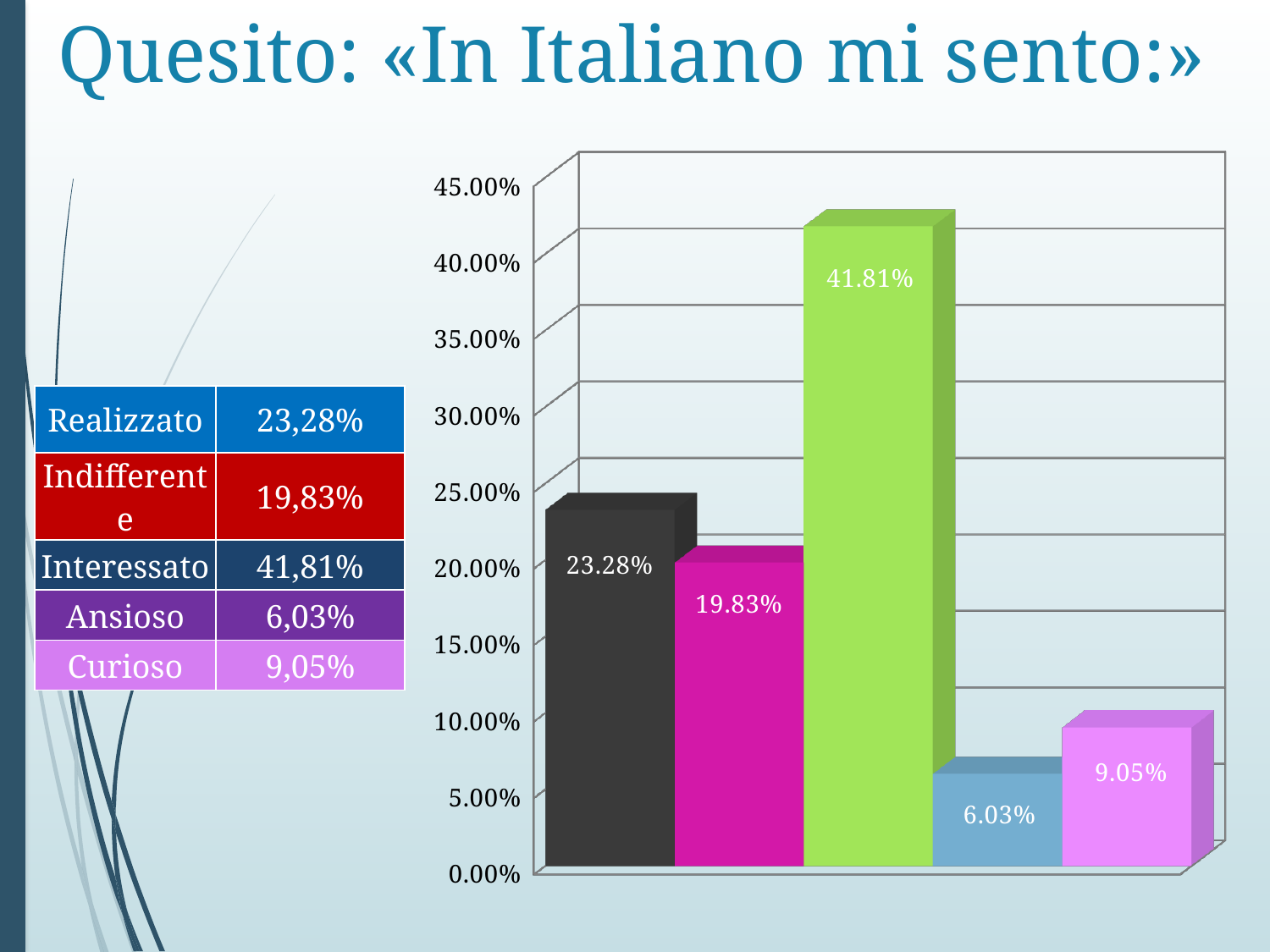
How many bars does the chart contain? 5 Is the value of the green bar greater or less than 40.00%? greater Which is larger, the magenta bar (19.83%) or the pink bar (9.05%)? the magenta bar (19.83%) What is the value shown on the shortest bar of the chart? 6.03% What is the title shown at the top of the slide? Quesito: «In Italiano mi sento:» What value is labelled on the leftmost (black) bar? 23.28% What is the difference between the green bar (41.81%) and the black bar (23.28%)? 18.53% According to the table, which category corresponds to the tallest bar (41.81%)? Interessato According to the table, which category corresponds to the shortest bar (6.03%)? Ansioso What value is labelled on the rightmost (pink) bar? 9.05% What is the value shown on the tallest bar of the chart? 41.81% What kind of chart is shown on the slide? bar chart